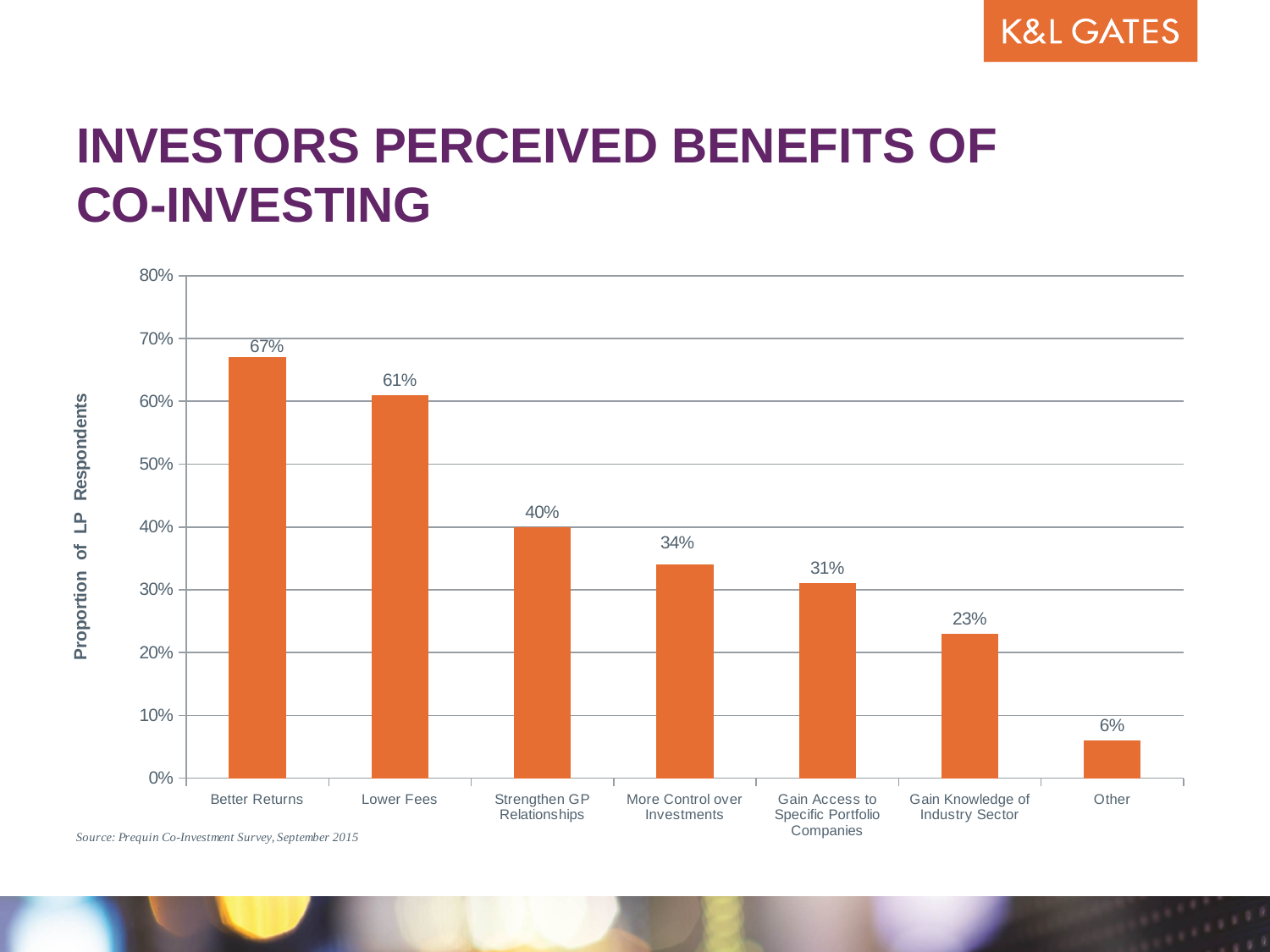
What is the difference between the values for Better Returns and Lower Fees? 6% Do the values rise or fall moving from left to right along the x axis? Fall What is the label of the vertical axis? Proportion of LP Respondents Which category has the lowest proportion of LP respondents? Other How many categories are shown on the chart? 7 Which category has the highest proportion of LP respondents? Better Returns What is the difference between the values for Strengthen GP Relationships and More Control over Investments? 6% What proportion of LP respondents cited Better Returns as a benefit of co-investing? 67% Which is larger: the value for Gain Access to Specific Portfolio Companies or the value for Gain Knowledge of Industry Sector? Gain Access to Specific Portfolio Companies What kind of chart is shown on the slide? Bar chart What is the value for Lower Fees? 61% What proportion of LP respondents cited Gain Knowledge of Industry Sector? 23%